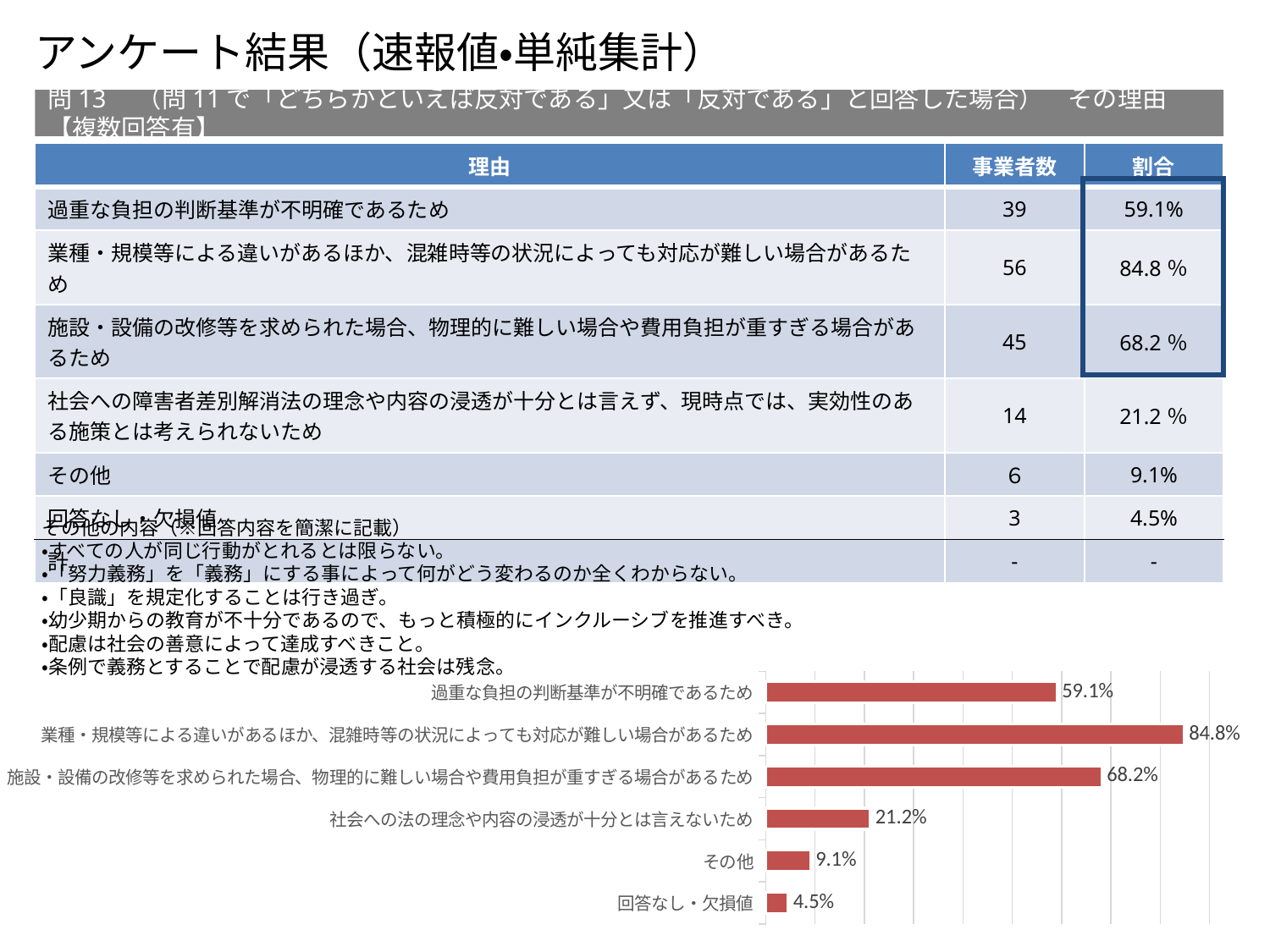
In the bar chart, what is the difference between the values for 業種・規模等による違いがあるほか、混雑時等の状況によっても対応が難しい場合があるため and 施設・設備の改修等を求められた場合、物理的に難しい場合や費用負担が重すぎる場合があるため? 16.6% Which category has the lowest value in the bar chart? 回答なし・欠損値 In the bar chart, which is larger: the value for 過重な負担の判断基準が不明確であるため or the value for 施設・設備の改修等を求められた場合、物理的に難しい場合や費用負担が重すぎる場合があるため? 施設・設備の改修等を求められた場合、物理的に難しい場合や費用負担が重すぎる場合があるため In the bar chart, what is the value for 過重な負担の判断基準が不明確であるため? 59.1% In the bar chart, what is the value for その他? 9.1% Which category has the highest value in the bar chart? 業種・規模等による違いがあるほか、混雑時等の状況によっても対応が難しい場合があるため What kind of chart is shown at the bottom of the slide? bar chart In the bar chart, what is the difference between the values for その他 and 回答なし・欠損値? 4.6% What colour are the bars in the bar chart? red How many categories does the bar chart show? 6 In the bar chart, what is the value for 社会への法の理念や内容の浸透が十分とは言えないため? 21.2% In the bar chart, what is the value for 回答なし・欠損値? 4.5%